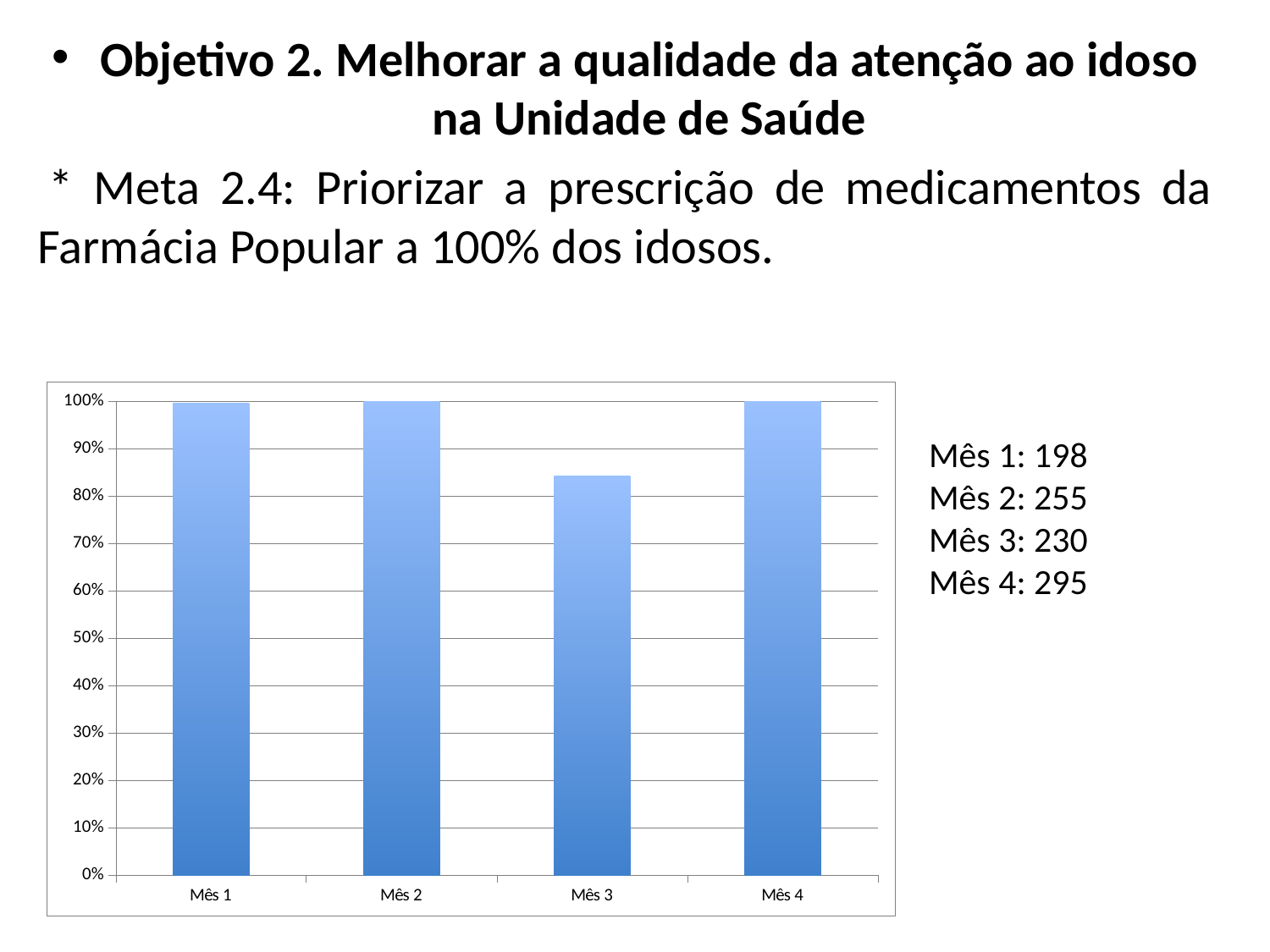
What kind of chart is shown on the slide? bar chart What is the highest tick label on the y axis of the chart? 100% What is the label of the third category on the x axis? Mês 3 Which is larger, the value for Mês 2 or the value for Mês 3? Mês 2 What is the value for Mês 2 in the chart? 100% Is the value for Mês 3 greater or less than 90%? less What is the value for Mês 4 in the chart? 100% Is the value for Mês 3 greater or less than 80%? greater How many categories are shown on the x axis of the chart? 4 Which category has the lowest value in the chart? Mês 3